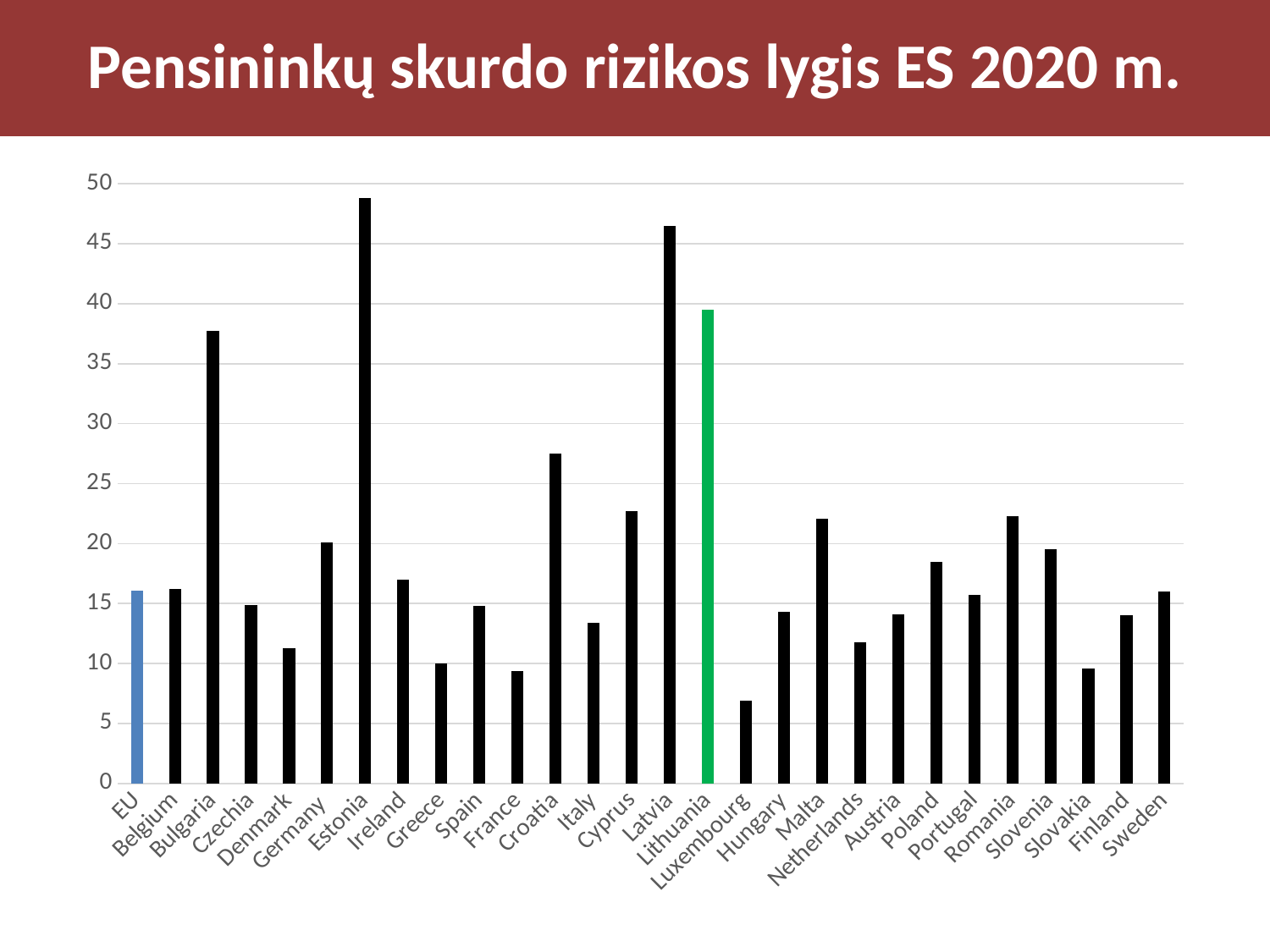
Is the value for France greater or less than 10? less Is the value for Croatia greater or less than 25? greater How many categories are plotted on the x axis? 28 Is the value for Cyprus greater or less than 20? greater Which category has the lowest value? Luxembourg Which is larger, the value for Croatia or the value for Cyprus? Croatia Which is larger, the value for Estonia or the value for Latvia? Estonia Which category's bar is coloured green? Lithuania Which category has the highest value? Estonia What kind of chart is shown on the slide? bar chart